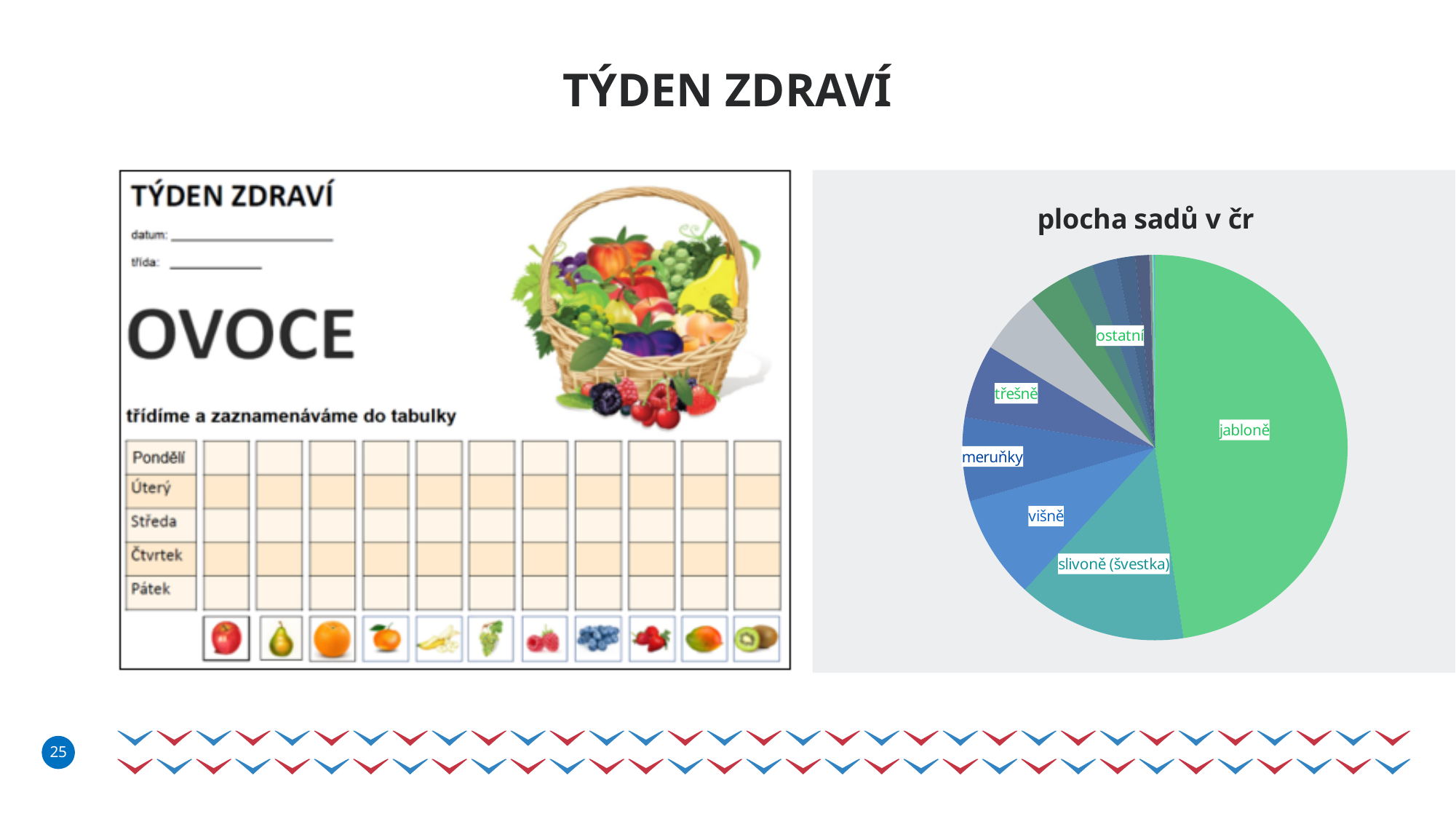
Which slice is larger in the pie chart, višně or meruňky? višně Which slice is larger in the pie chart, jabloně or slivoně (švestka)? jabloně Which slice is larger in the pie chart, jabloně or třešně? jabloně What colour is the jabloně slice in the pie chart? green What kind of chart is shown on the right side of the slide? pie chart Which category has the largest slice in the pie chart? jabloně What is the title of the pie chart? plocha sadů v čr